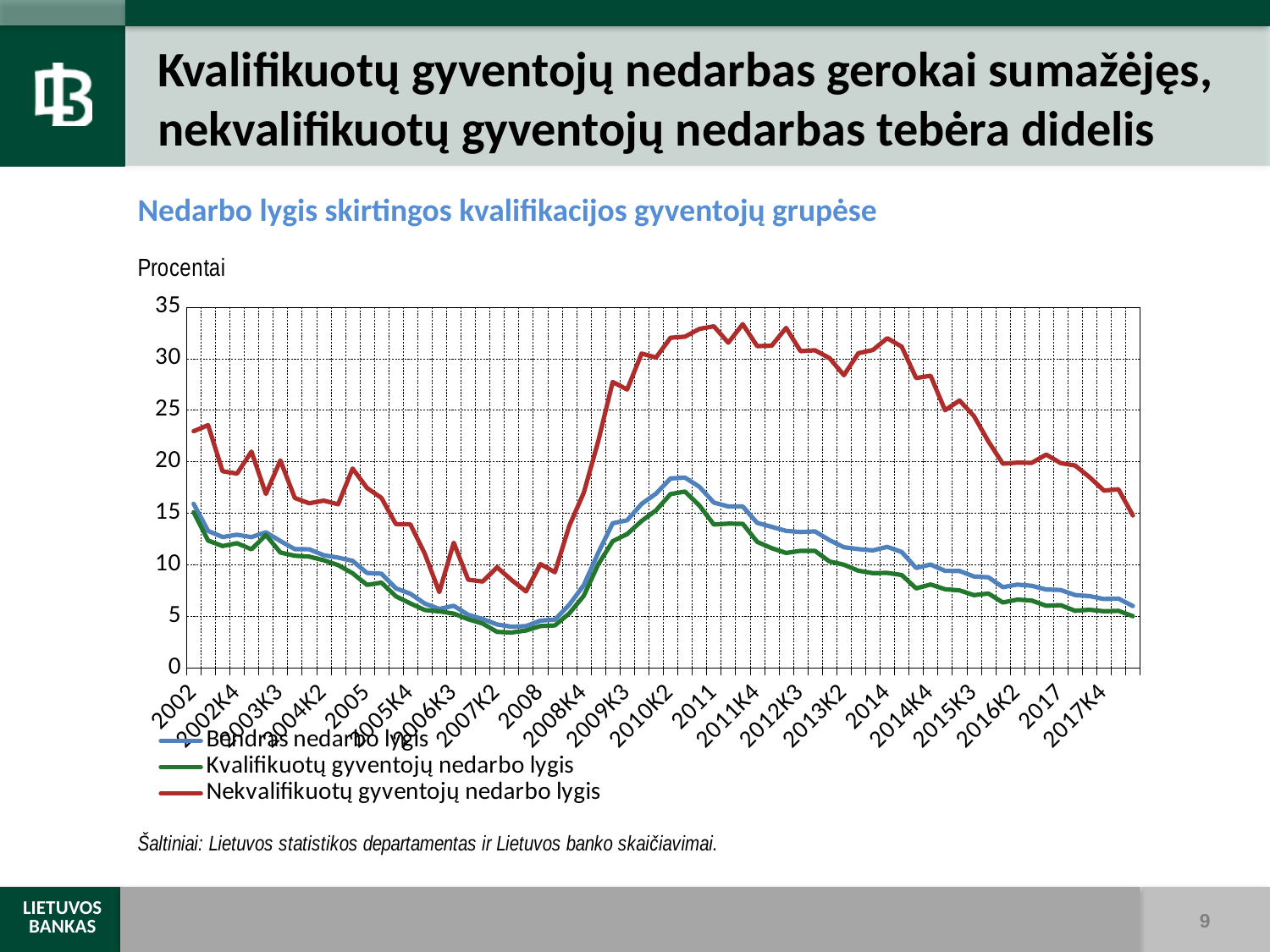
Is the peak value of Nekvalifikuotų gyventojų nedarbo lygis around 2011 greater or less than 30? greater What unit is indicated above the vertical axis of the chart? Procentai Is the value of Kvalifikuotų gyventojų nedarbo lygis at 2007K2 greater or less than 5? less Is the value of Bendras nedarbo lygis at 2010K2 greater or less than 15? greater Which series has the lowest values across the whole period shown? Kvalifikuotų gyventojų nedarbo lygis What kind of chart is shown on the slide? line chart Does Bendras nedarbo lygis rise or fall from 2010K2 to 2017K4? fall What is the title of the chart? Nedarbo lygis skirtingos kvalifikacijos gyventojų grupėse How many series does the legend list? 3 At 2011, which is larger: Nekvalifikuotų gyventojų nedarbo lygis or Kvalifikuotų gyventojų nedarbo lygis? Nekvalifikuotų gyventojų nedarbo lygis Which series has the highest values across the whole period shown? Nekvalifikuotų gyventojų nedarbo lygis